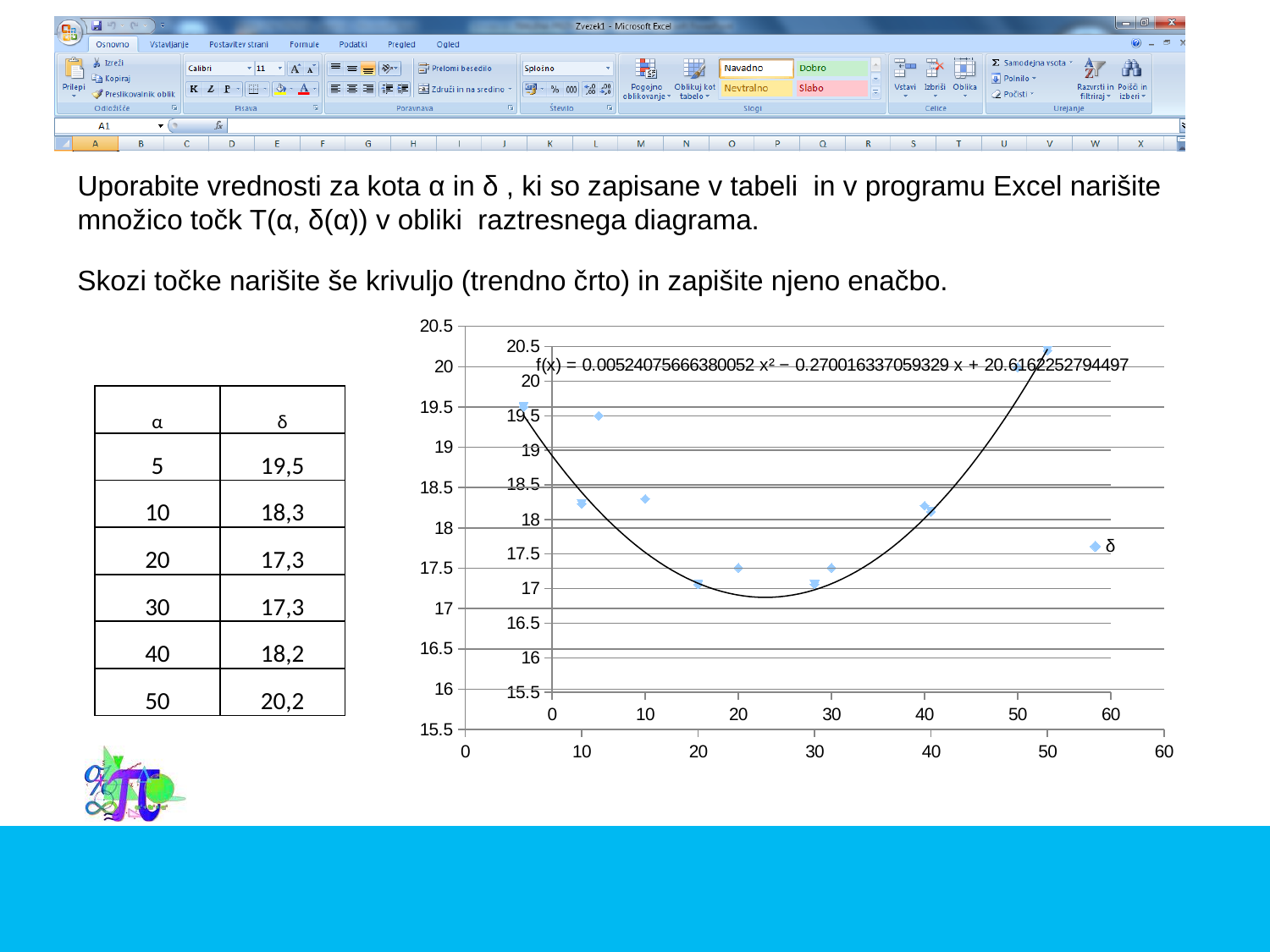
Is the plotted value at α = 5 greater or less than 19? greater How many series does the chart legend list? 1 What is the name of the series shown in the chart legend? δ Is the plotted value at α = 50 greater or less than 19.5? greater What kind of chart is shown on the slide? scatter chart At which α value is the plotted δ highest? 50 Is the plotted value at α = 20 greater or less than 18? less How do the plotted values change as α increases from 0 to 60? they fall and then rise Which has the larger plotted value, α = 5 or α = 10? α = 5 Which has the larger plotted value, α = 40 or α = 50? α = 50 How many data points are plotted in the scatter chart? 6